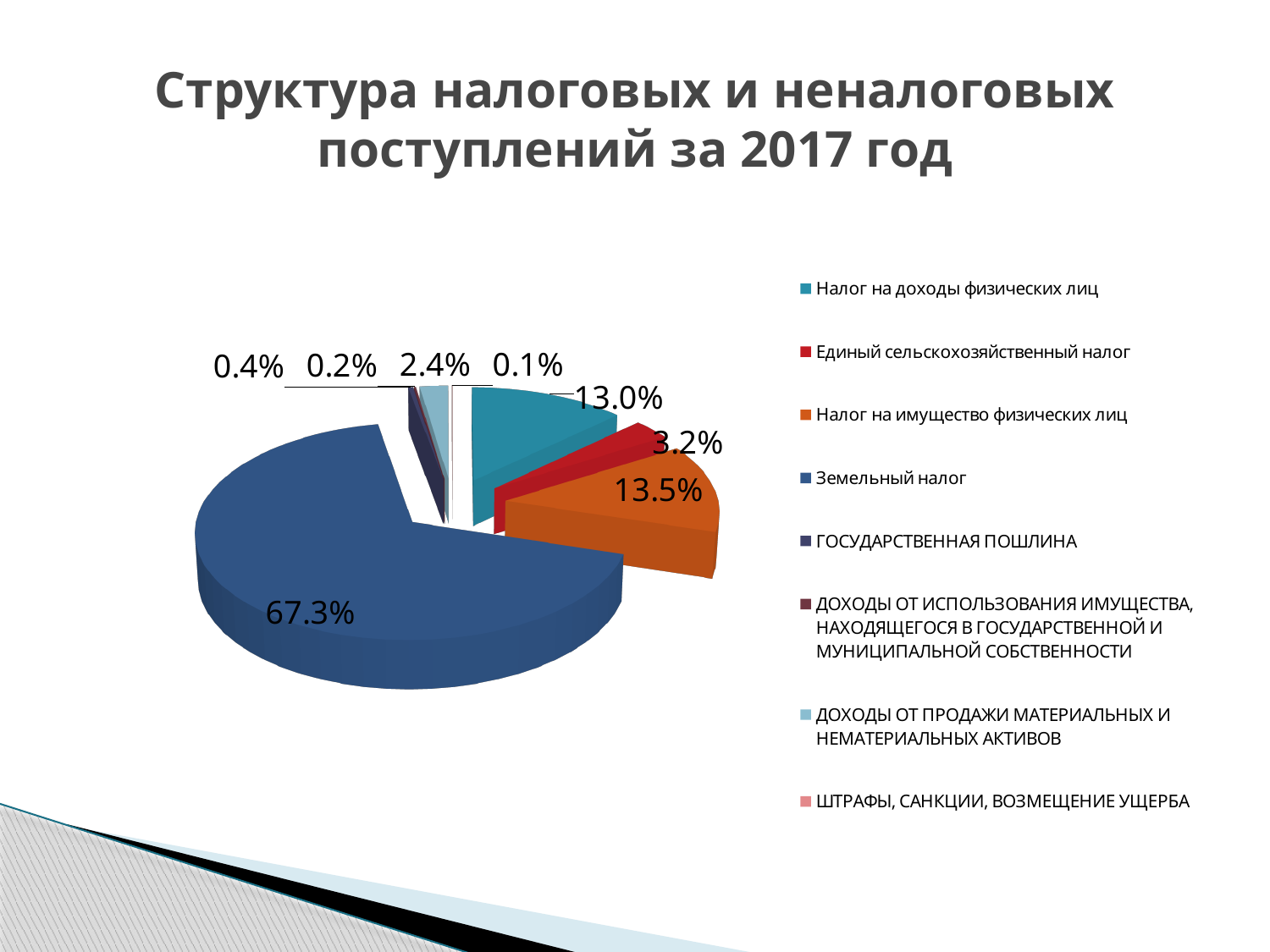
What is the share of Земельный налог in the pie chart? 67.3% What kind of chart is shown on the slide? pie chart What is the share of Единый сельскохозяйственный налог? 3.2% What is the share of Налог на имущество физических лиц? 13.5% What is the title of the slide? Структура налоговых и неналоговых поступлений за 2017 год Which category has the largest share of the pie? Земельный налог What is the share of ДОХОДЫ ОТ ПРОДАЖИ МАТЕРИАЛЬНЫХ И НЕМАТЕРИАЛЬНЫХ АКТИВОВ? 2.4% Which is larger: Налог на имущество физических лиц or Налог на доходы физических лиц? Налог на имущество физических лиц How many categories does the legend list? 8 What colour is the slice for Земельный налог? blue What is the difference in percentage points between Земельный налог and Налог на имущество физических лиц? 53.8 What is the share of Налог на доходы физических лиц? 13.0%